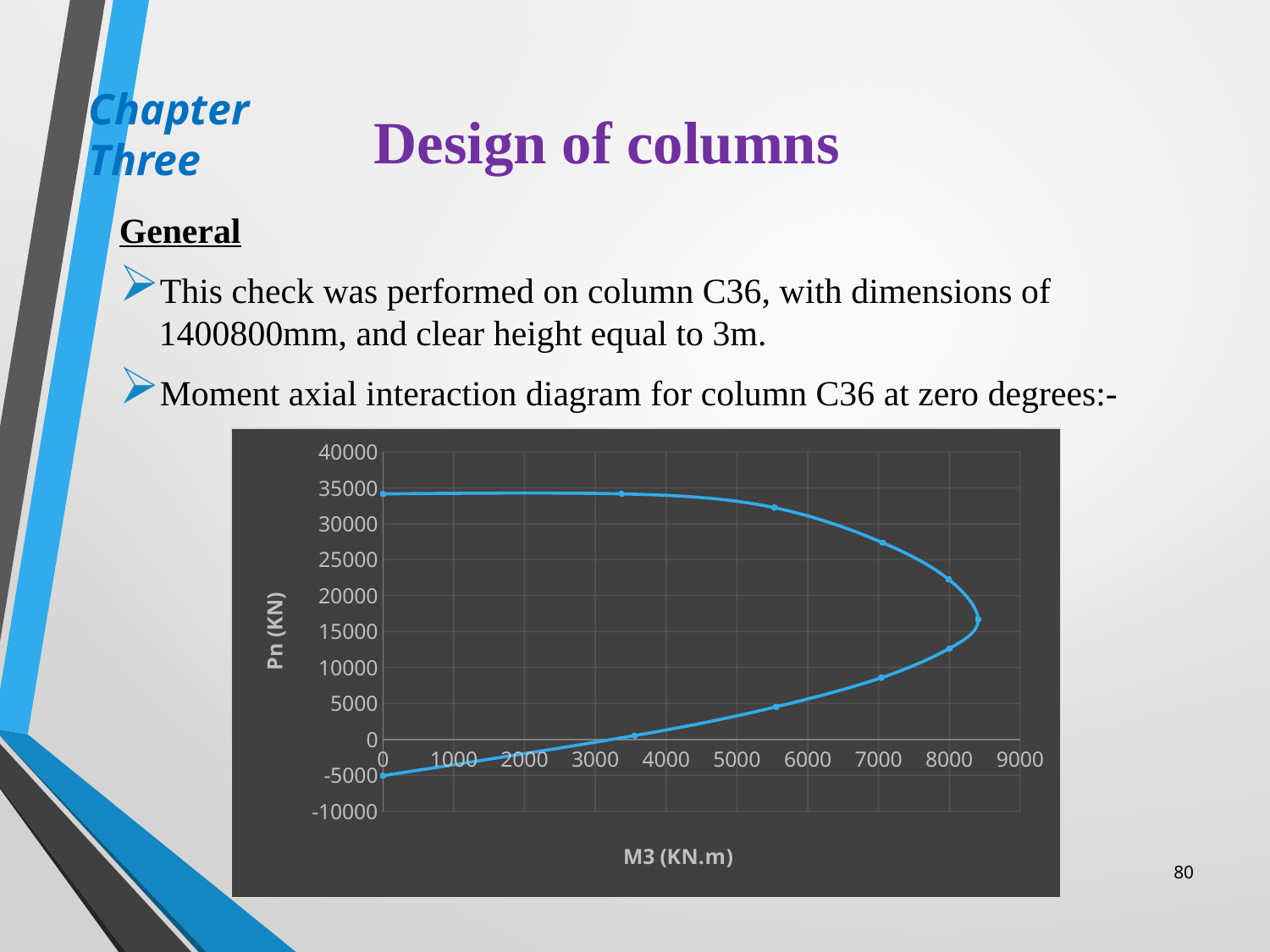
What kind of chart is shown on the slide? Line chart Is the largest M3 value reached by the curve greater or less than 8000? greater Is the Pn value at the point where M3 is about 3000 on the upper branch greater or less than 30000? greater What is the title of the horizontal axis of the chart? M3 (KN.m) Is the lowest Pn value on the curve greater or less than 0? less What is the lowest tick value shown on the Pn axis? -10000 What is the highest tick value shown on the Pn axis? 40000 What is the title of the vertical axis of the chart? Pn (KN) How many data points are marked on the interaction curve? 11 Along the lower branch of the curve, does Pn rise or fall as M3 increases from 0 to about 8000? rise What is the highest tick value shown on the M3 axis? 9000